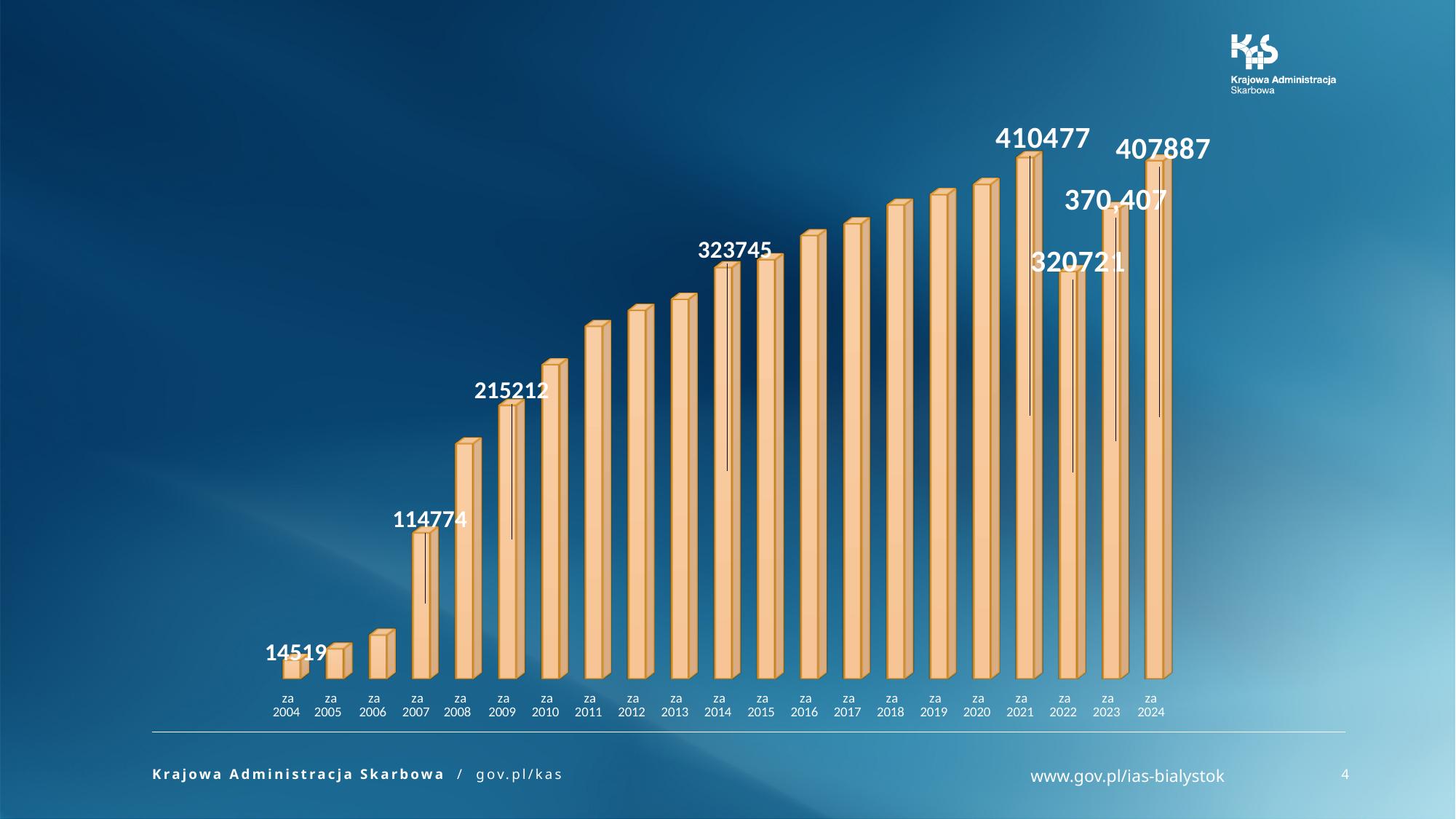
What kind of chart is shown on the slide? bar chart Which year has the lowest value? za 2004 Which year has the highest value? za 2021 Which is larger, the value for za 2014 or the value for za 2009? za 2014 What is the value for za 2014? 323745 What is the value for za 2023? 370,407 What is the value for za 2009? 215212 What is the difference between the values for za 2021 and za 2022? 89756 What is the value for za 2004? 14519 What is the value for za 2007? 114774 How many years (bars) are shown in the chart? 21 What is the difference between the values for za 2023 and za 2022? 49686